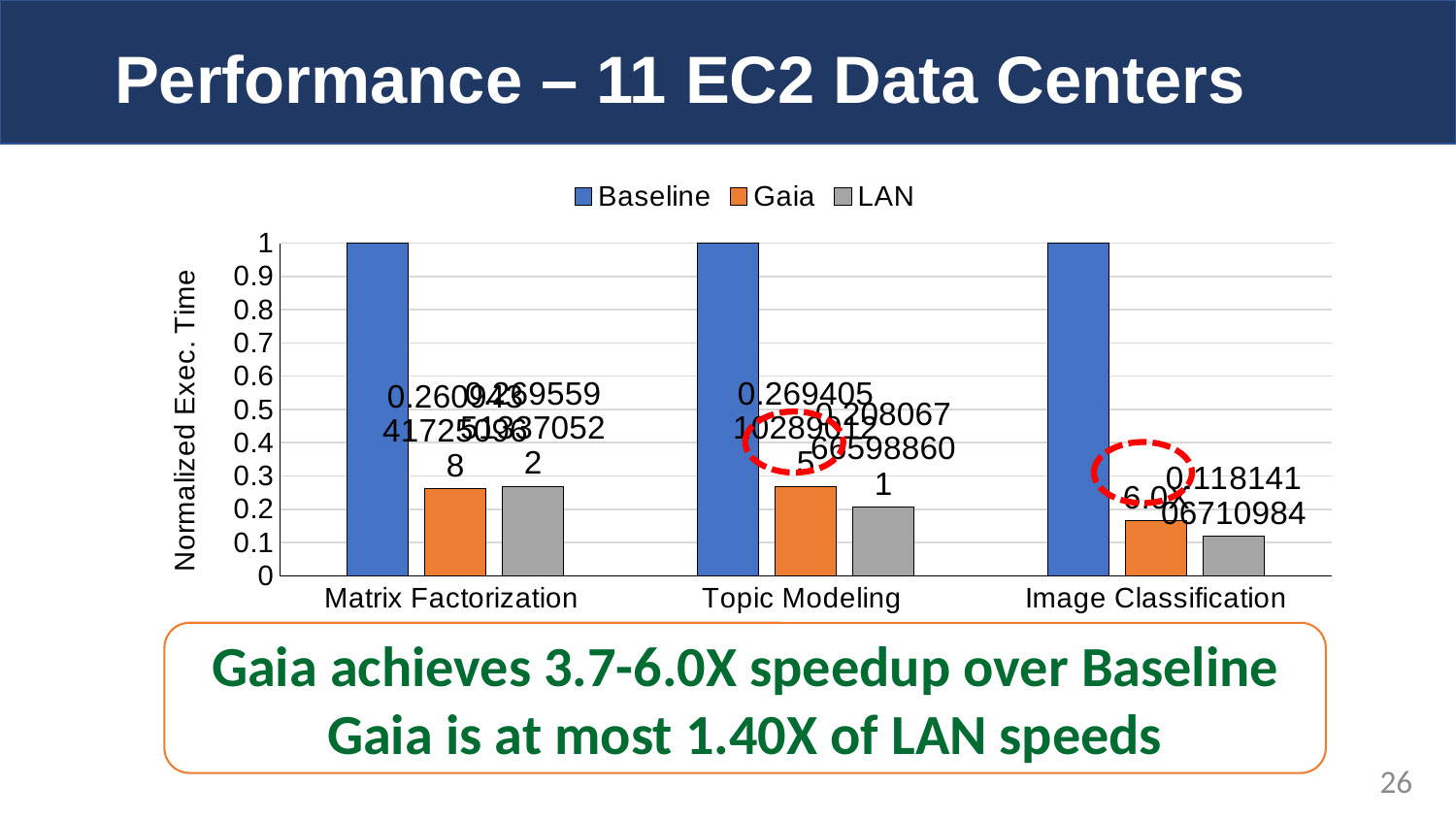
Which series has the highest value for Topic Modeling? Baseline What is the Baseline value for Image Classification? 1 How many categories are shown on the x axis? 3 What kind of chart is shown on the slide? bar chart What is the label of the y axis? Normalized Exec. Time Is the Gaia value for Image Classification greater or less than 0.2? less Is the LAN value for Topic Modeling greater or less than 0.3? less Which series has the lowest value for Topic Modeling? LAN For Topic Modeling, which is larger: the Gaia value or the LAN value? Gaia Which series has the lowest value for Image Classification? LAN What is the Baseline value for Matrix Factorization? 1 How many series does the legend list? 3